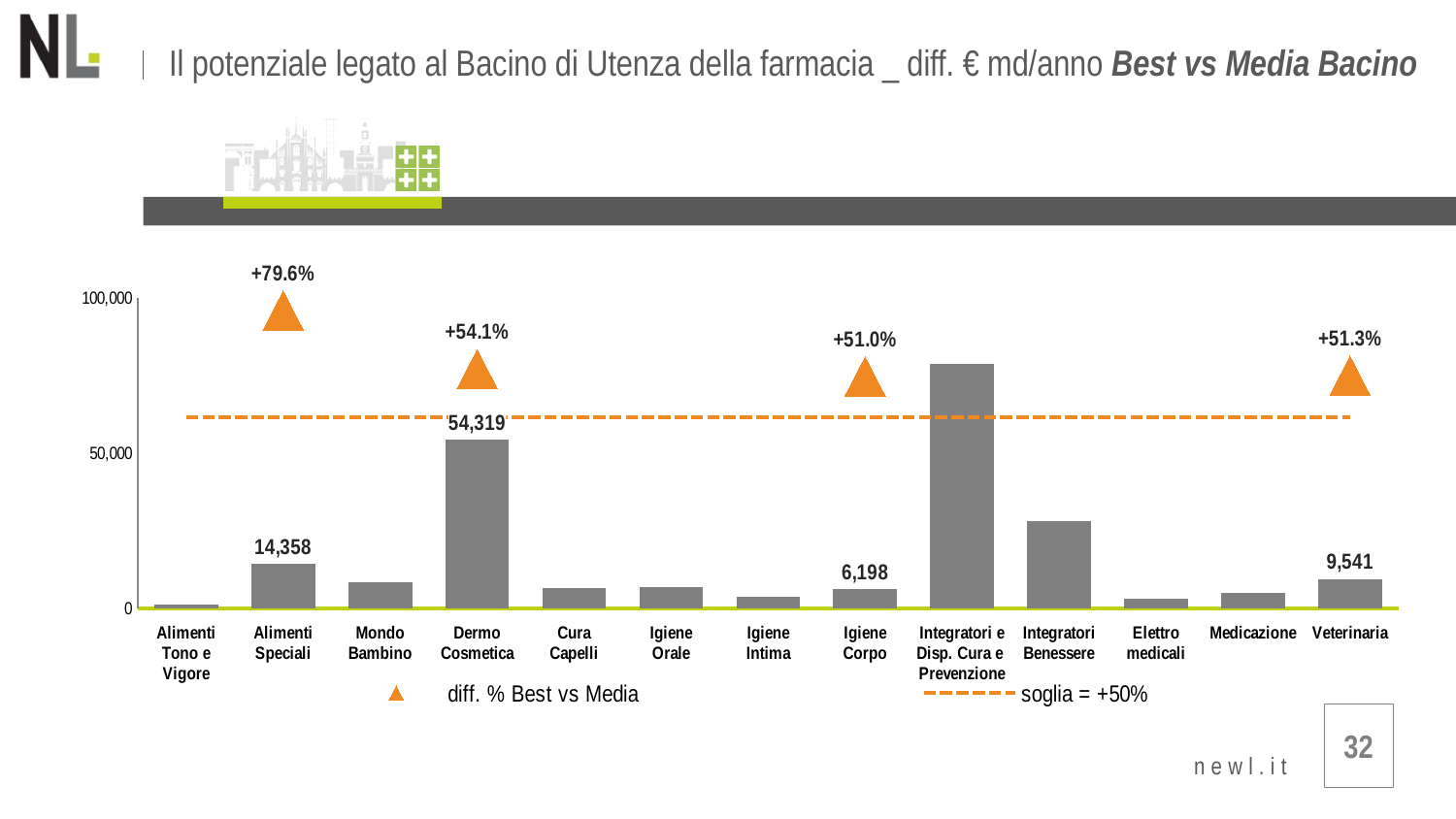
What value does the dashed line (soglia) represent according to the legend? +50% How many categories are shown on the x axis? 13 What is the diff. % Best vs Media shown above Alimenti Speciali? +79.6% Is the value for Integratori Benessere greater or less than 50,000? less What is the value for Igiene Corpo? 6,198 What is the value for Alimenti Speciali? 14,358 What is the value for Veterinaria? 9,541 Which is larger, the value for Veterinaria or the value for Igiene Corpo? Veterinaria What is the difference between the values for Dermo Cosmetica and Alimenti Speciali? 39,961 Which category has the highest bar? Integratori e Disp. Cura e Prevenzione What is the diff. % Best vs Media shown above Dermo Cosmetica? +54.1% What is the value for Dermo Cosmetica? 54,319